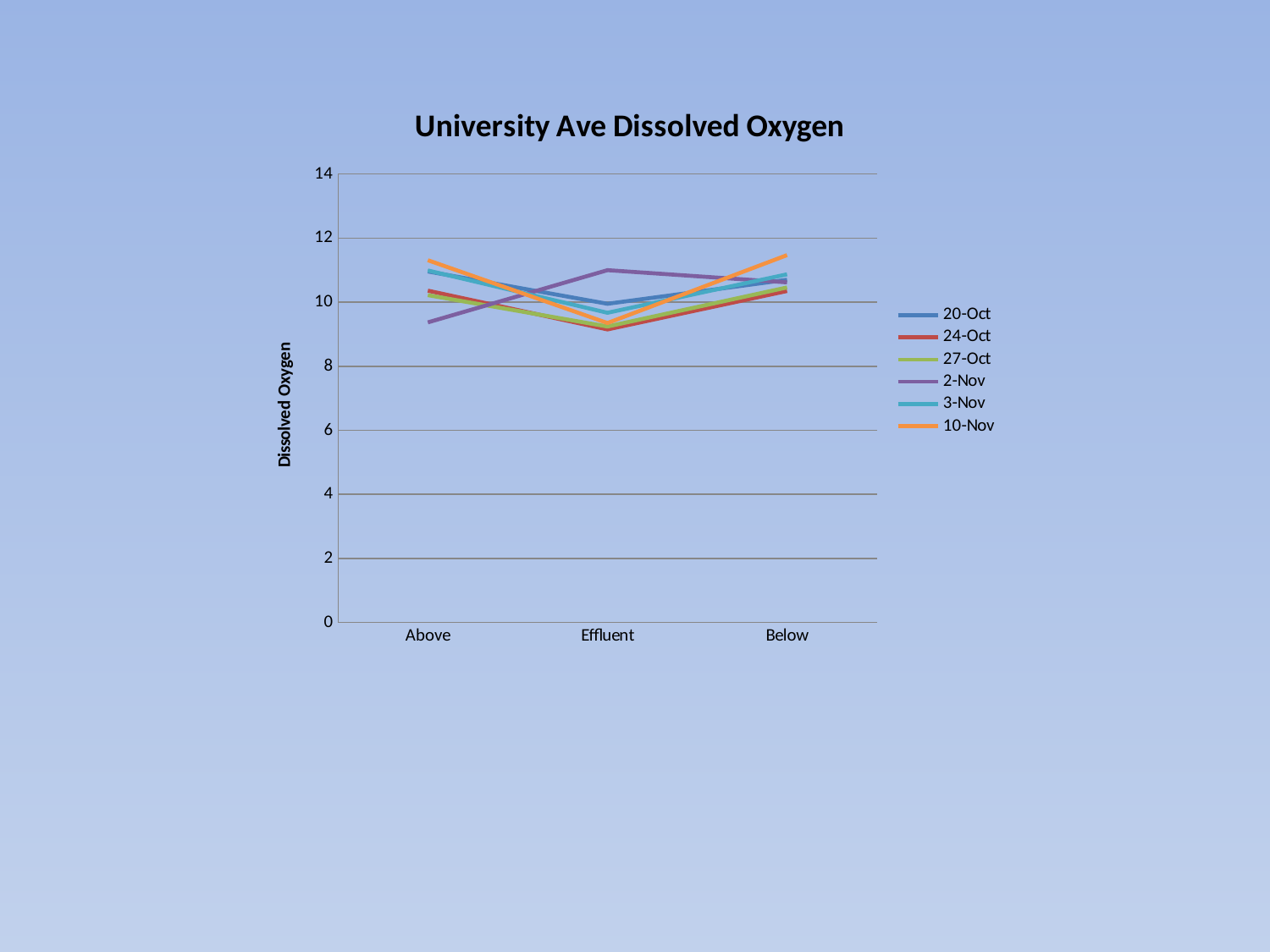
What is the title of the chart? University Ave Dissolved Oxygen Is the value for 2-Nov at Effluent greater or less than 10? greater What kind of chart is shown on the slide? Line chart How many series does the legend list? 6 What is the label on the vertical axis? Dissolved Oxygen Which series has the lowest value at Above? 2-Nov Which series has the highest value at Effluent? 2-Nov Does the 2-Nov line rise or fall from Above to Effluent? rise How many categories are shown on the x axis? 3 Is the value for 2-Nov at Above greater or less than 10? less Is the value for 24-Oct at Effluent greater or less than 10? less